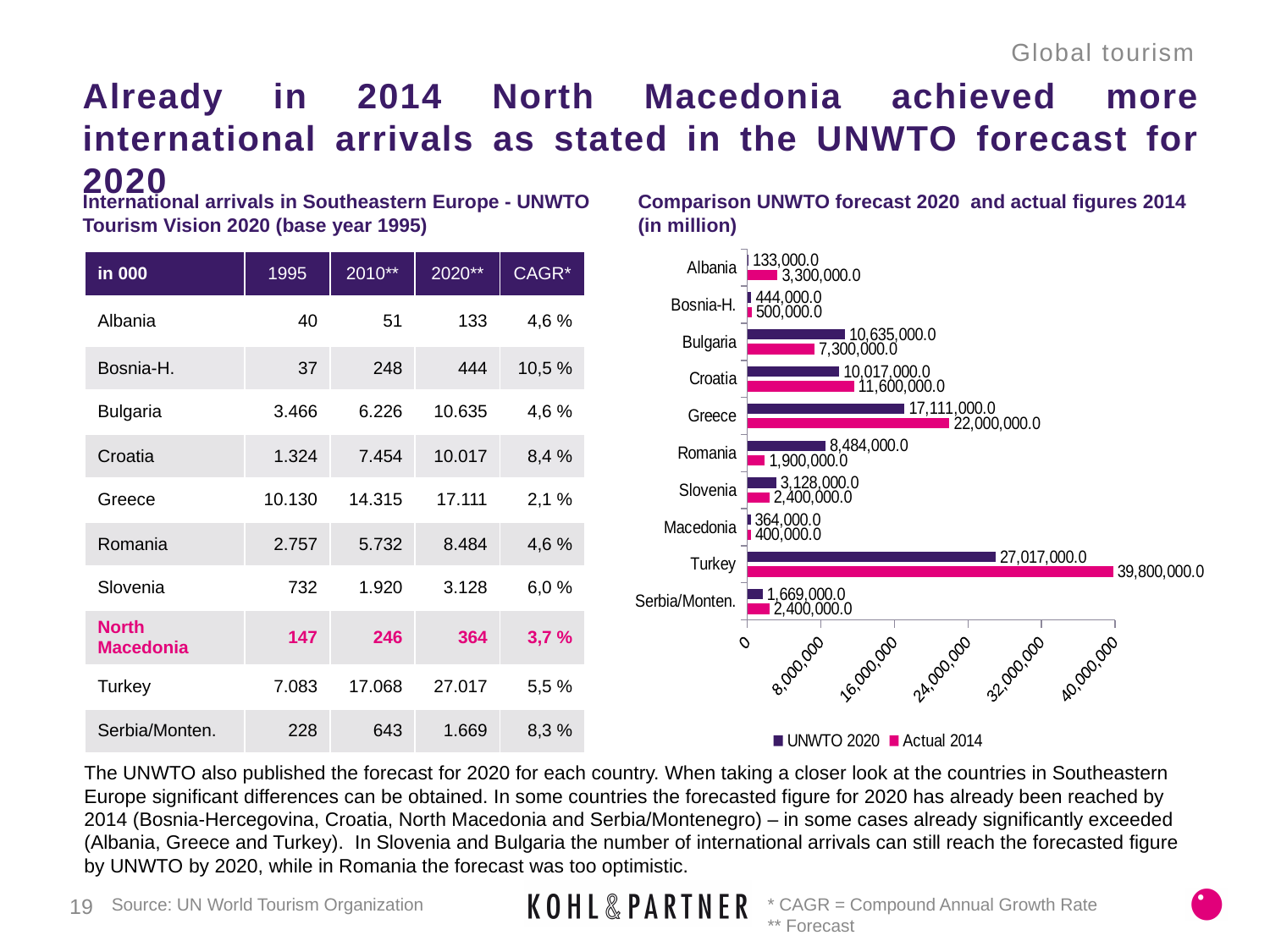
For Romania, which is larger: the UNWTO 2020 value or the Actual 2014 value? UNWTO 2020 Which country has the lowest UNWTO 2020 value in the chart? Albania What type of chart is shown on the slide? Bar chart What is the Actual 2014 value for Turkey in the chart? 39,800,000.0 How many countries are shown in the chart? 10 What is the difference between the Actual 2014 and UNWTO 2020 values for Turkey? 12,783,000.0 Which series is shown in pink in the chart? Actual 2014 Is the Actual 2014 value for Greece greater or less than 16,000,000? greater What is the UNWTO 2020 value for Greece in the chart? 17,111,000.0 How many series does the chart legend list? 2 Which country has the highest UNWTO 2020 value in the chart? Turkey What is the Actual 2014 value for Albania in the chart? 3,300,000.0